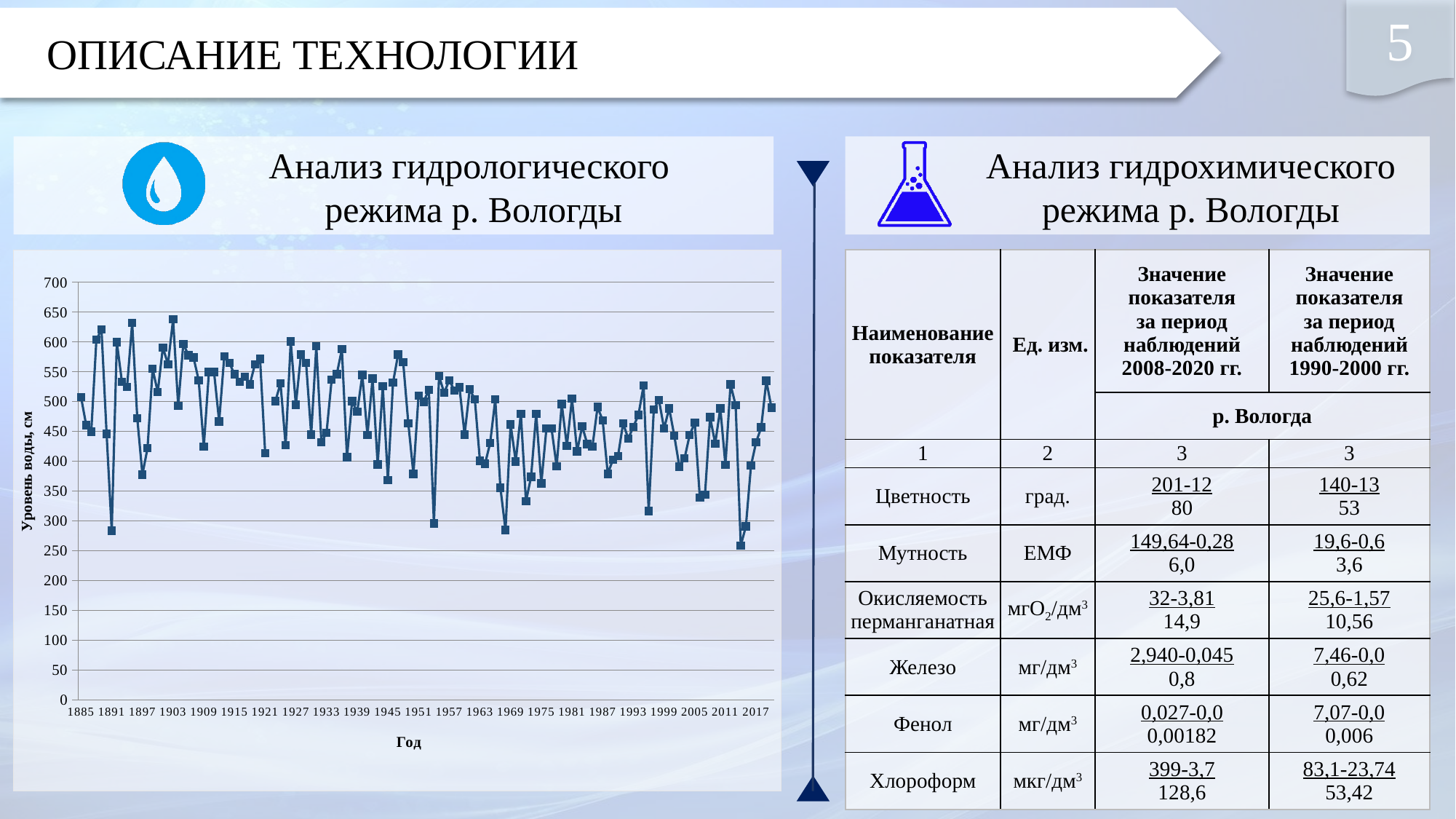
What is the title of the vertical axis of the line chart? Уровень воды, см What is the last year labelled on the horizontal axis of the line chart? 2017 In the line chart, which year has the higher water level, 1969 or 1975? 1969 What kind of chart is shown on the left side of the slide? line chart What is the highest value shown on the vertical axis of the line chart? 700 What is the title of the horizontal axis of the line chart? Год In the line chart, is the water level for 1969 greater or less than 300? greater In the line chart, is the water level for 1903 greater or less than 600? greater In the line chart, which year has the higher water level, 1891 or 1903? 1903 What is the first year labelled on the horizontal axis of the line chart? 1885 In the line chart, is the water level for 1895 greater or less than 600? greater